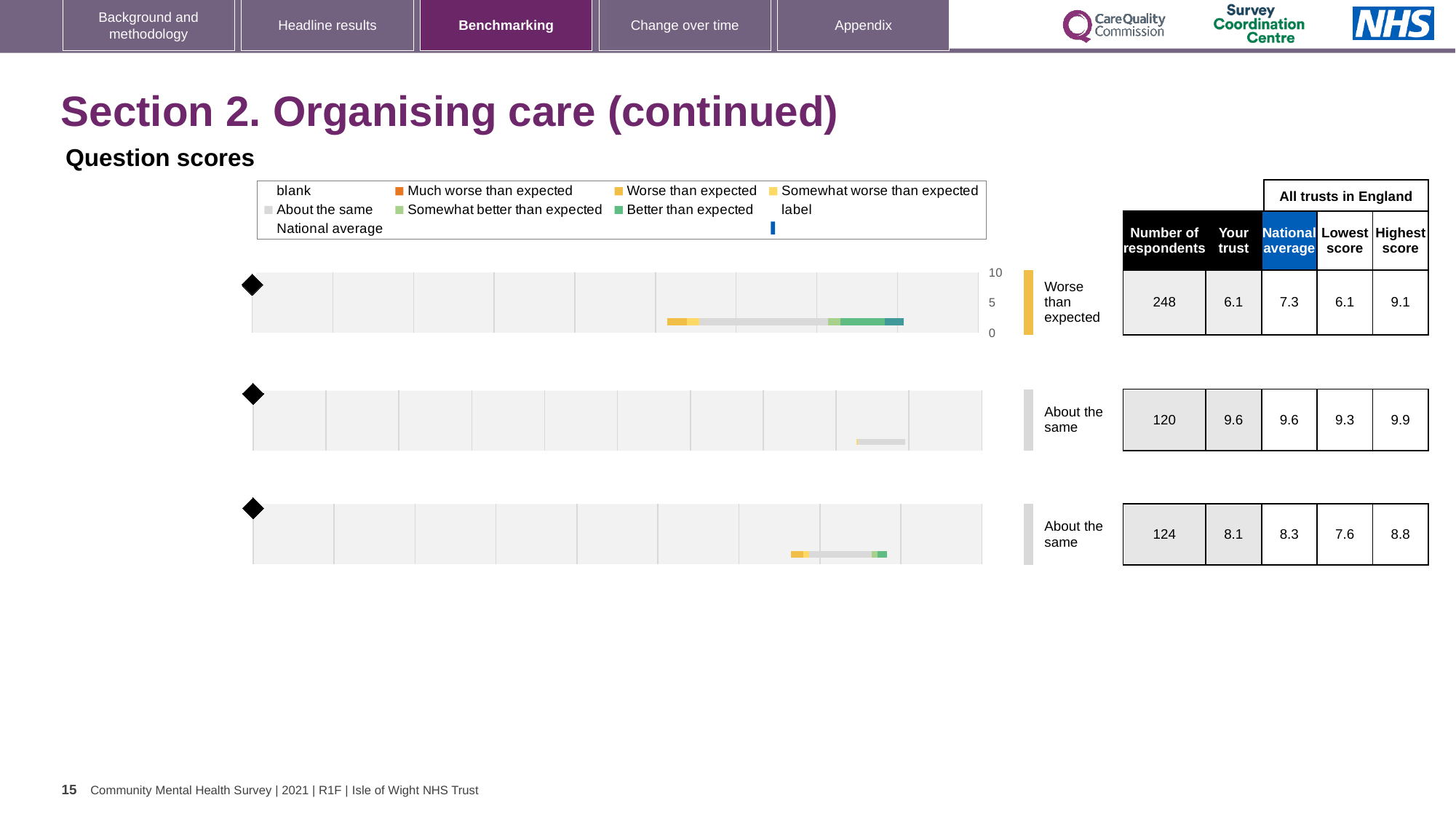
How many benchmarking charts are shown on the slide? 3 In the first (top) chart, what is the 'Your trust' score shown in the table? 6.1 In the third (bottom) chart, which is larger: the 'Your trust' score or the national average? National average In the first (top) chart, what is the difference between the national average and the 'Your trust' score? 1.2 In the third (bottom) chart, what is the lowest score across all trusts in England? 7.6 In the first (top) chart, what is the national average score? 7.3 In the second (middle) chart, what is the highest score across all trusts in England? 9.9 What benchmark category label is shown next to the first (top) chart? Worse than expected In the second (middle) chart, what is the difference between the highest score and the lowest score? 0.6 In the first (top) chart, how many respondents are shown in the table? 248 Which chart has the highest 'Your trust' score? The second (middle) chart What type of chart is used for the benchmarking displays on this slide? Bar chart